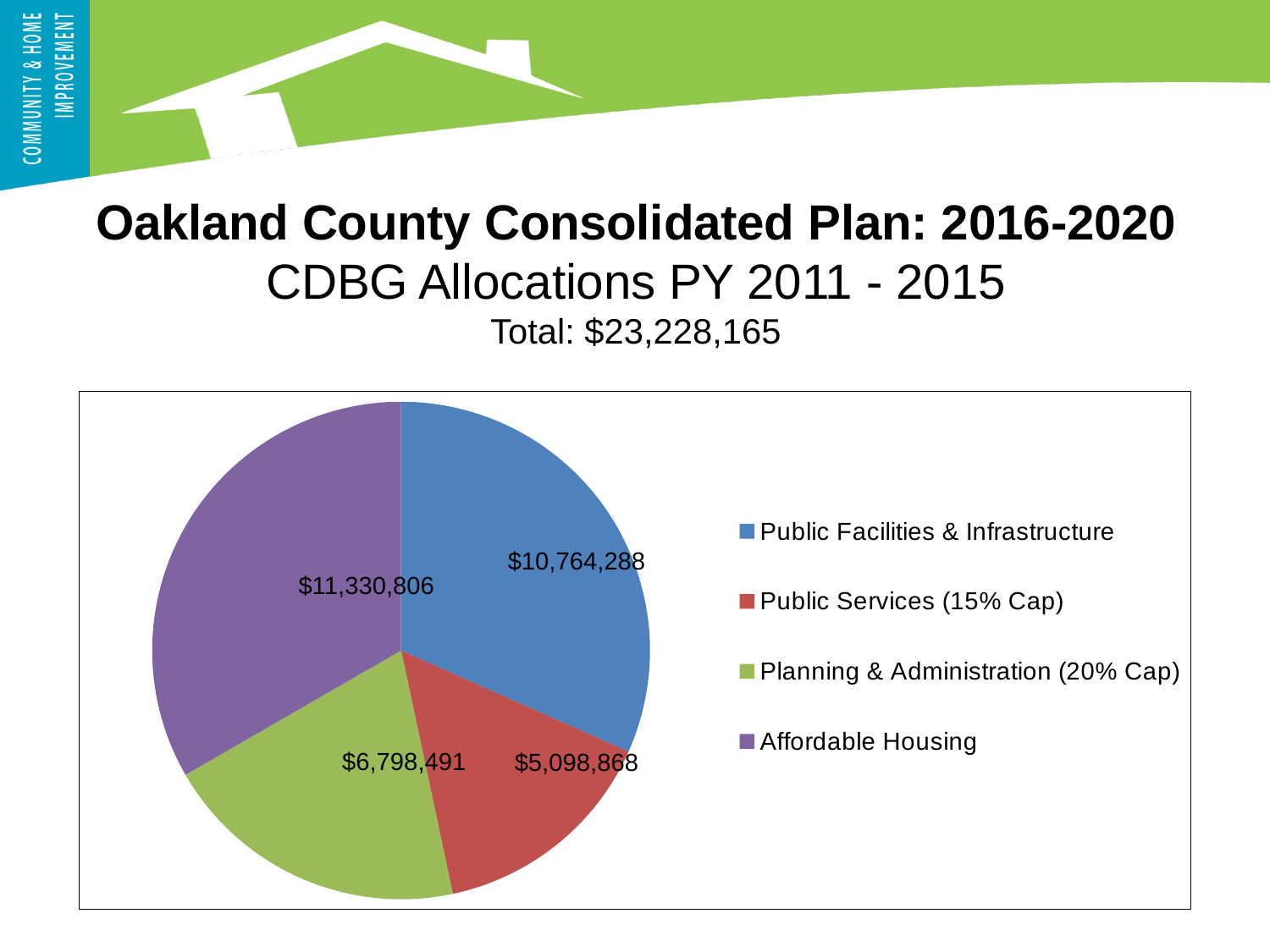
Which category has the largest allocation? Affordable Housing Which is larger, Planning & Administration (20% Cap) or Public Services (15% Cap)? Planning & Administration (20% Cap) How many categories are shown in the pie chart? 4 What is the difference between the Affordable Housing and Public Facilities & Infrastructure allocations? $566,518 Which colour represents Affordable Housing in the pie chart? Purple Which category has the smallest allocation? Public Services (15% Cap) What kind of chart is shown on the slide? Pie chart What is the value for Public Facilities & Infrastructure? $10,764,288 What is the value for Public Services (15% Cap)? $5,098,868 What is the value for Affordable Housing? $11,330,806 What is the difference between the Planning & Administration (20% Cap) and Public Services (15% Cap) allocations? $1,699,623 What is the value for Planning & Administration (20% Cap)? $6,798,491